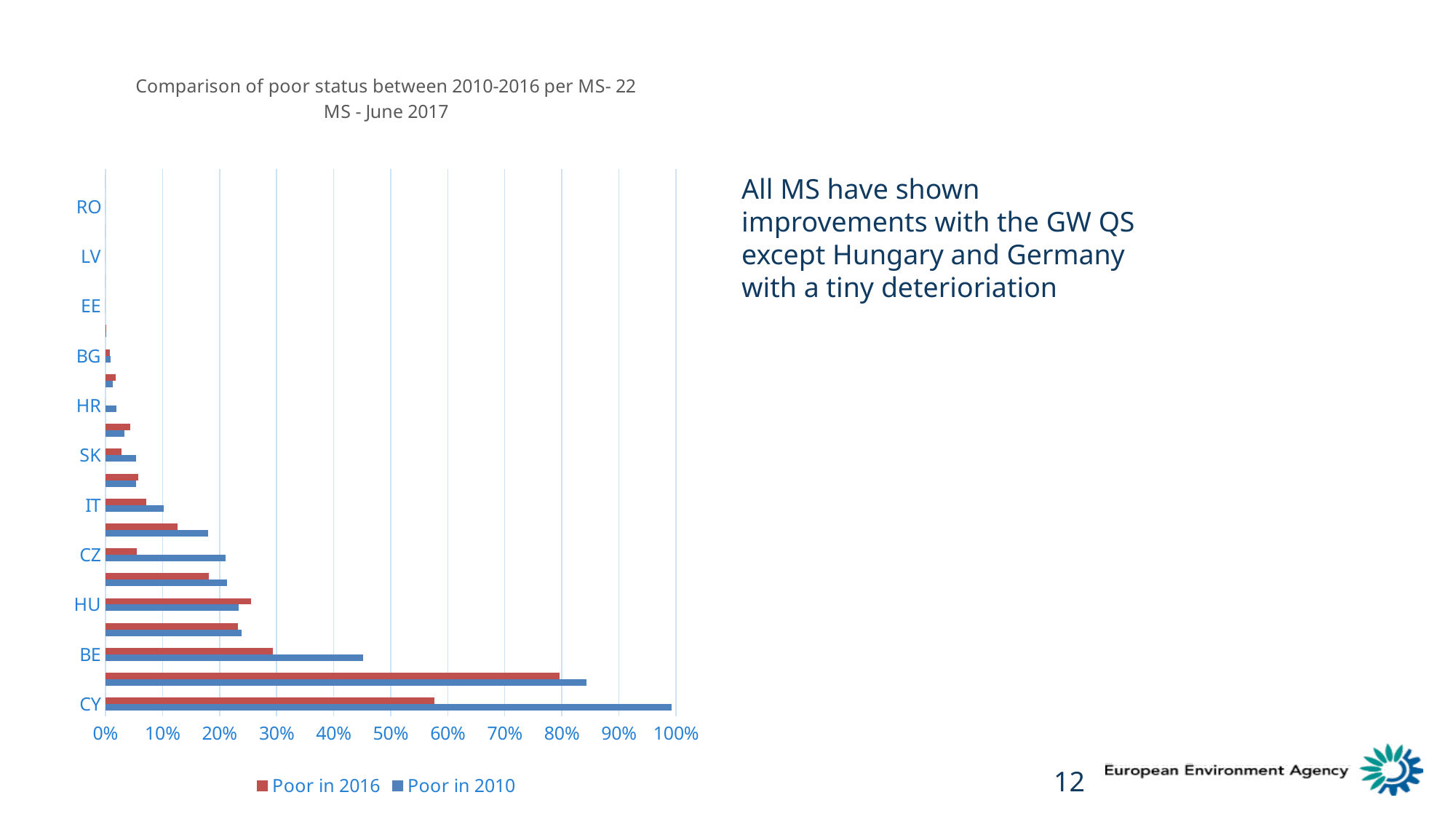
Is the 'Poor in 2010' value for BE greater or less than 40%? greater For CY, which is larger: 'Poor in 2016' or 'Poor in 2010'? Poor in 2010 For BE, which is larger: 'Poor in 2016' or 'Poor in 2010'? Poor in 2010 For CZ, which is larger: 'Poor in 2016' or 'Poor in 2010'? Poor in 2010 Which colour represents the 'Poor in 2010' series? Blue Is the 'Poor in 2016' value for CY greater or less than 50%? greater What are the two series named in the legend? Poor in 2016 and Poor in 2010 What kind of chart is shown on the slide? Bar chart Is the 'Poor in 2010' value for CY greater or less than 90%? greater Which member state has the highest 'Poor in 2010' value? CY How many series does the legend list? 2